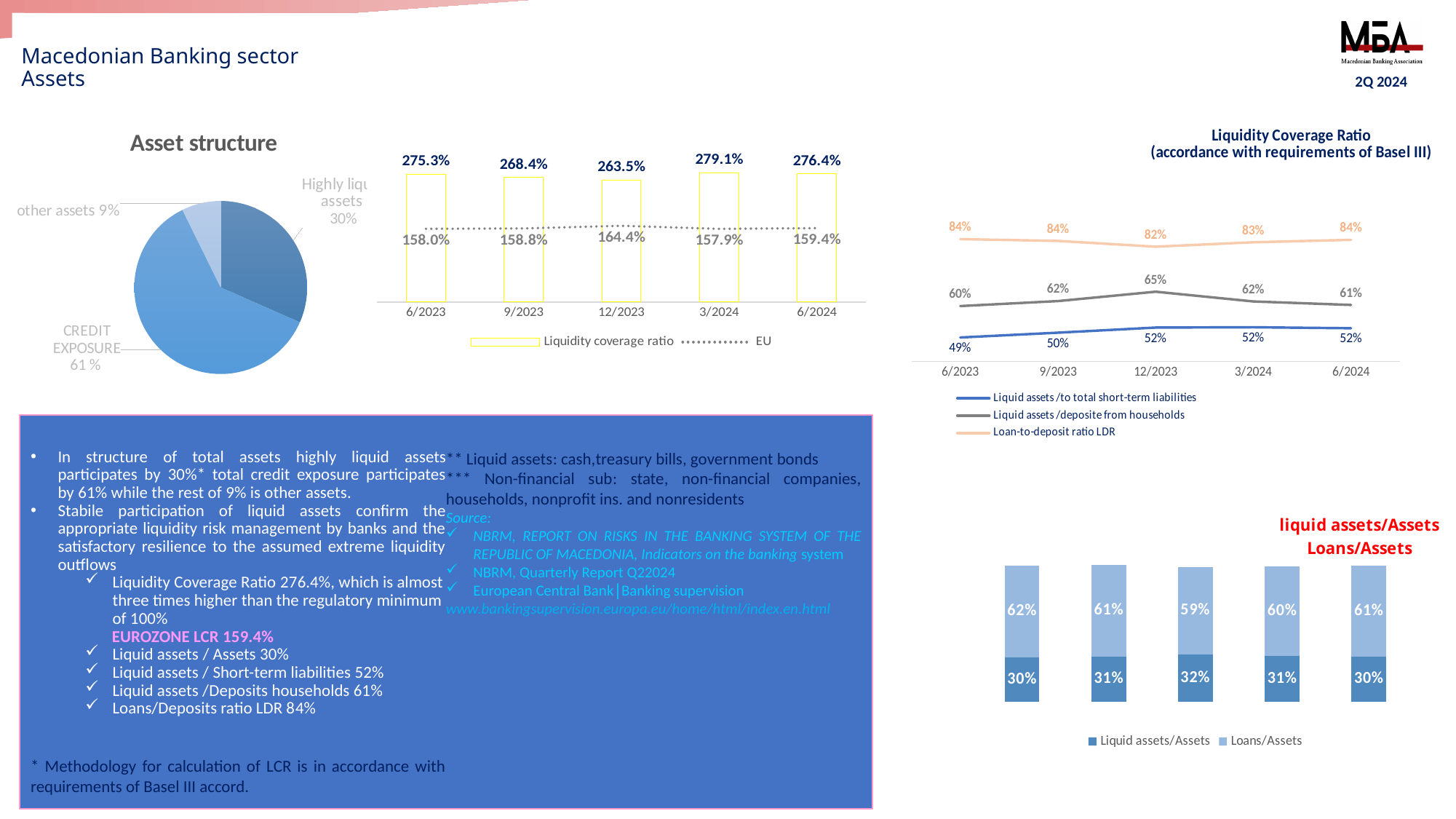
In the liquid assets/Assets Loans/Assets chart at the bottom right, what is the Liquid assets/Assets value in the third bar? 32% In the Liquidity coverage ratio bar chart, what is the EU value for 12/2023? 164.4% In the liquid assets/Assets Loans/Assets chart at the bottom right, what kind of chart is it? Stacked bar chart In the Liquidity coverage ratio bar chart, which period has the lowest Liquidity coverage ratio? 12/2023 In the Liquidity Coverage Ratio (accordance with requirements of Basel III) line chart, how many series does the legend list? 3 In the Asset structure pie chart, which slice is the smallest? other assets In the Liquidity Coverage Ratio (accordance with requirements of Basel III) line chart, what is the Loan-to-deposit ratio LDR for 12/2023? 82% In the Asset structure pie chart, what share is CREDIT EXPOSURE? 61% In the Liquidity Coverage Ratio (accordance with requirements of Basel III) line chart, in which period is Liquid assets /deposite from households highest? 12/2023 In the Liquidity coverage ratio bar chart, what is the difference between the Liquidity coverage ratio and the EU value for 6/2024? 117.0% In the Liquidity coverage ratio bar chart, what is the Liquidity coverage ratio for 3/2024? 279.1% In the Asset structure pie chart, how many slices are there? 3